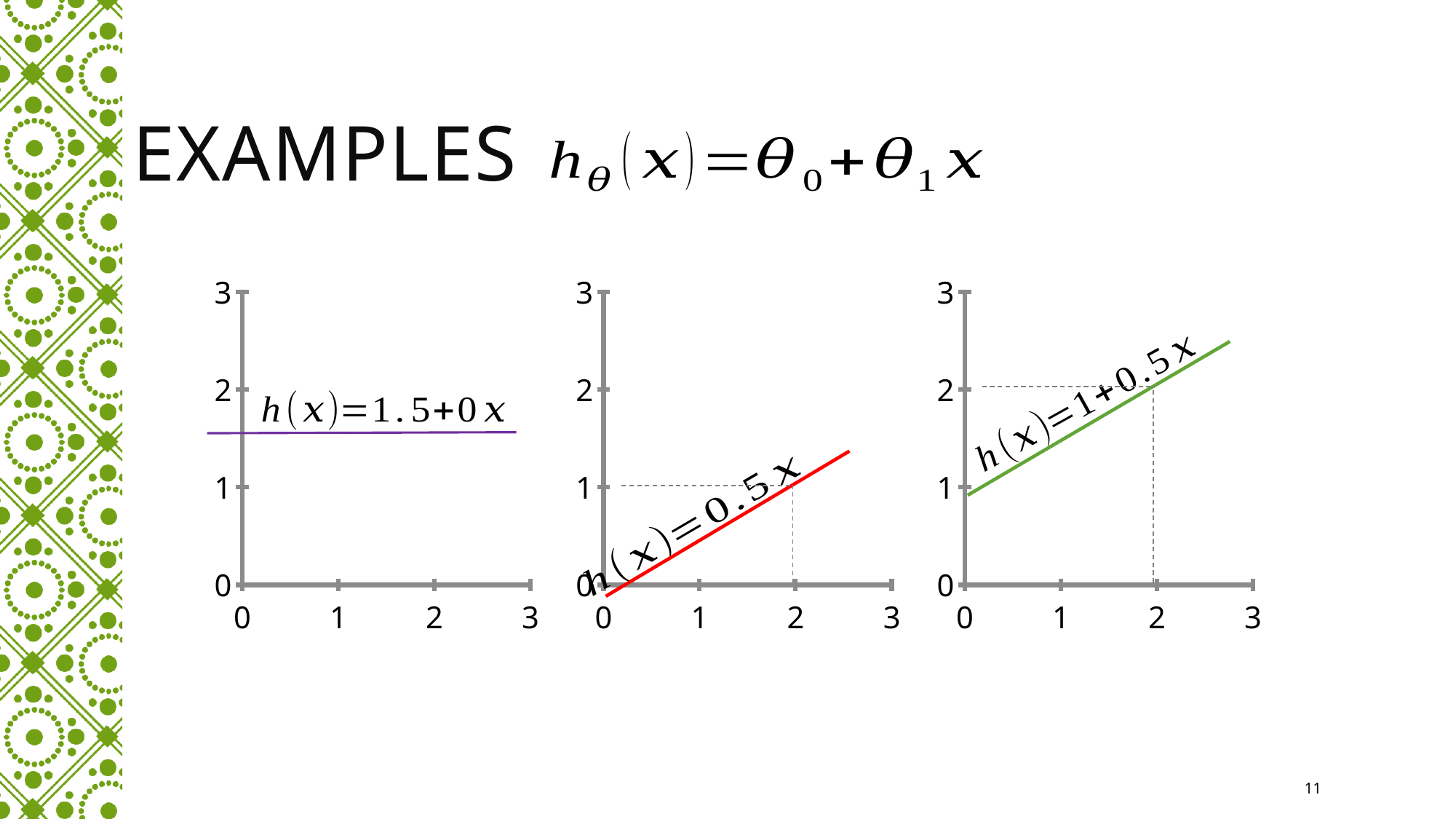
What colour is the plotted line in the middle chart? red In the right chart, does the plotted line rise or fall as x increases? rises What is the difference between the value at x = 2 in the right chart and the value at x = 2 in the middle chart? 1 What kind of chart is the left chart on the slide? line chart How many charts are shown on the slide? 3 In the middle chart (red line), what is the value of h(x) at x = 2, as marked by the dashed line? 1 At x = 2, which chart shows the larger value: the middle chart or the right chart? the right chart In the right chart (green line), what is the value of h(x) at x = 2, as marked by the dashed line? 2 In the left chart, does the plotted line rise, fall, or stay flat as x increases? stays flat In the left chart, is the value of h(x) at x = 1 greater or less than 1? greater In the left chart, is the value of h(x) at x = 1 greater or less than 2? less What function is labelled on the left chart? h(x)=1.5+0x